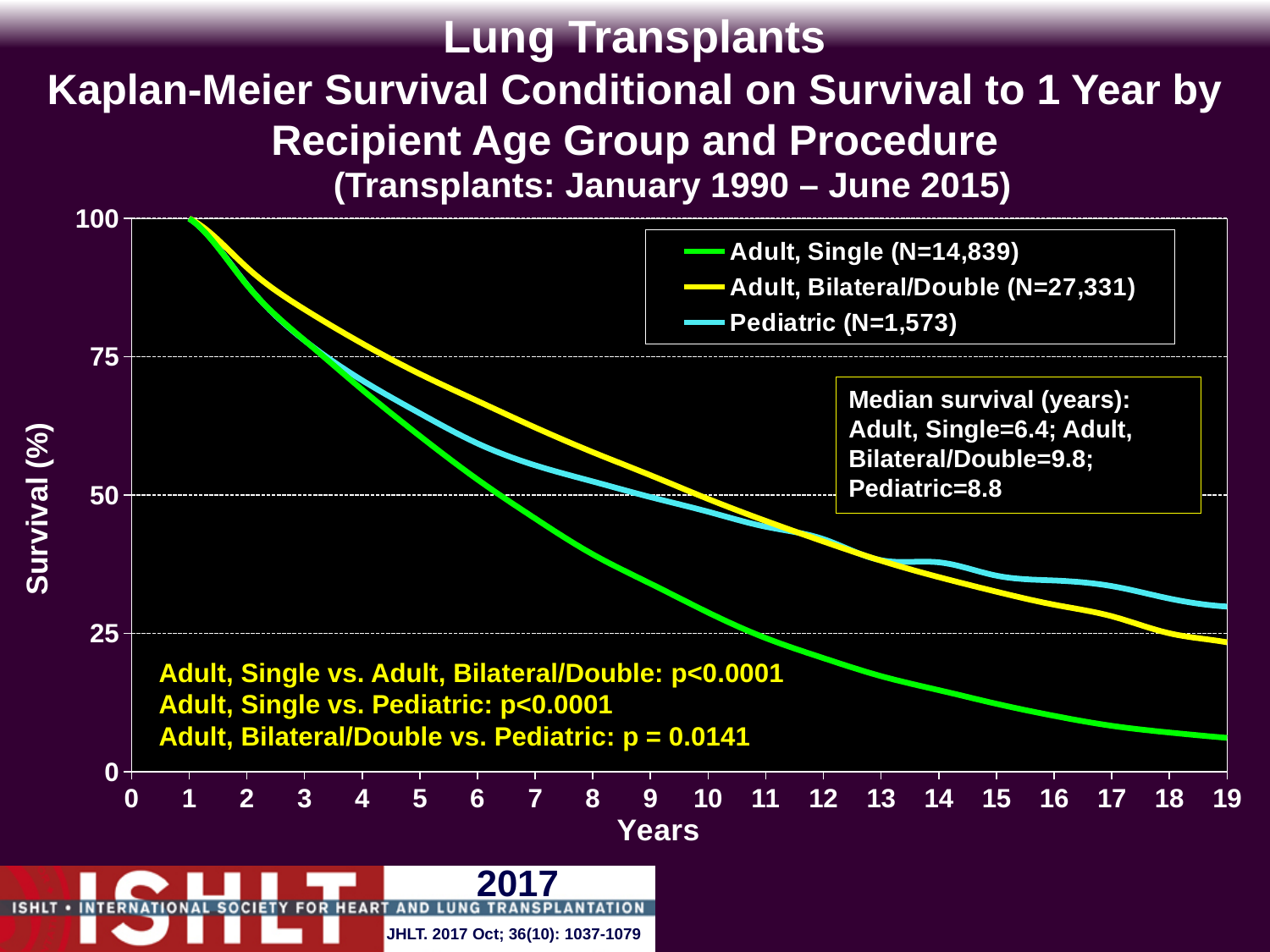
Which series has the highest survival at year 5? Adult, Bilateral/Double What is the N for the Pediatric series in the legend? 1,573 What kind of chart is shown on the slide? line chart Which series has the lowest survival at year 19? Adult, Single Is the survival value for Pediatric at year 19 greater or less than 25? greater Is the survival value for Adult, Single at year 19 greater or less than 25? less Which series has the highest survival at year 19? Pediatric At year 15, which is larger: the survival for Pediatric or for Adult, Single? Pediatric What is the median survival in years for Adult, Bilateral/Double recipients according to the text box? 9.8 How many series does the legend list? 3 Is the survival value for Adult, Single at year 5 greater or less than 50? greater Do the survival curves rise or fall as years increase? fall